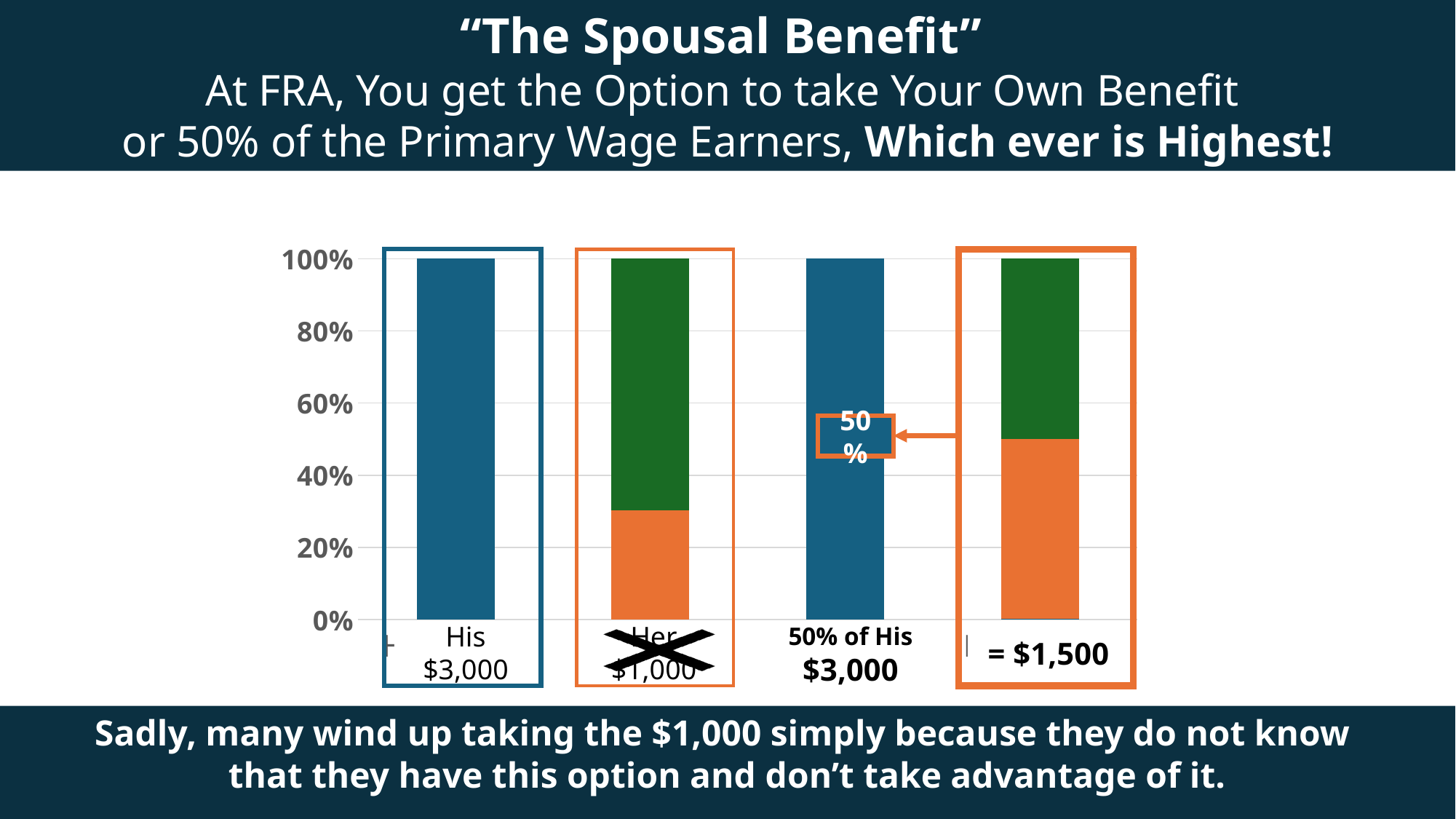
Is the orange segment of the "Her $1,000" bar greater or less than 40%? less Which category label on the x axis is crossed out? Her $1,000 What is the label printed under the rightmost bar? = $1,500 How many bars are plotted in the chart? 4 What dollar amount is printed under the "50% of His" bar? $3,000 What percentage does the bar labeled "His $3,000" reach on the y axis? 100% Which bar has the larger orange segment: the "Her $1,000" bar or the "= $1,500" bar? = $1,500 Is the orange segment of the "Her $1,000" bar greater or less than 20%? greater What percentage value is printed in the box with the arrow pointing to the rightmost bar? 50% What type of chart is shown on the slide? bar chart What is the highest value shown on the y axis? 100%